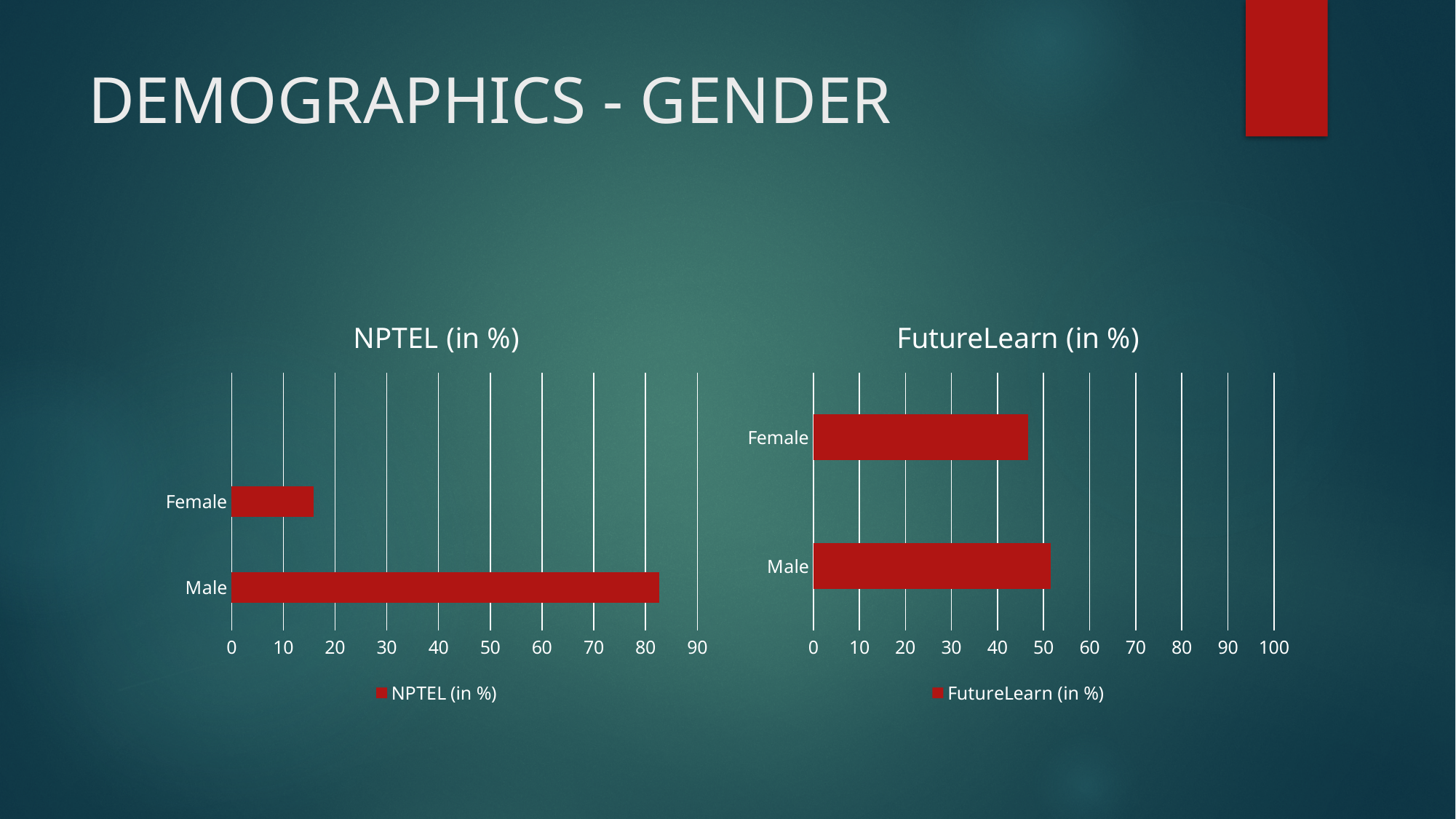
In the NPTEL (in %) chart, is the value for Male greater or less than 80? greater In the NPTEL (in %) chart, is the value for Female greater or less than 20? less How many categories are shown in the FutureLearn (in %) chart? 2 In the FutureLearn (in %) chart, is the value for Male greater or less than 50? greater In the FutureLearn (in %) chart, which is larger, the value for Male or the value for Female? Male In the NPTEL (in %) chart, which category has the highest value? Male What is the title of the chart on the left of the slide? NPTEL (in %) How many series does the legend of the NPTEL (in %) chart list? 1 What kind of chart is the NPTEL (in %) chart? bar chart What is the highest axis tick shown on the FutureLearn (in %) chart? 100 In the NPTEL (in %) chart, which category has the lowest value? Female